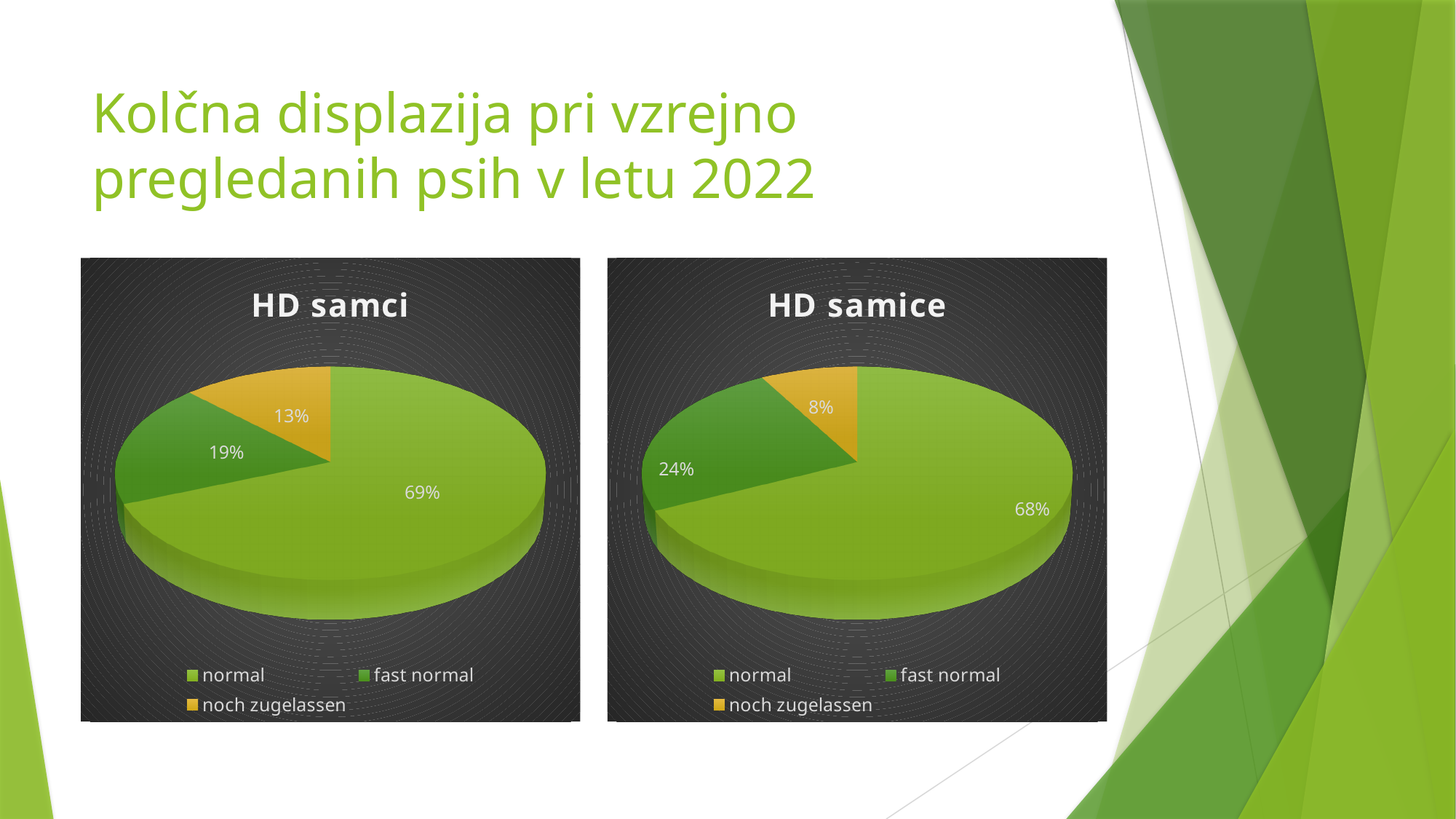
What type of chart is the 'HD samci' chart? pie chart In the 'HD samci' chart, what share of the pie is 'normal'? 69% Which chart has the larger 'fast normal' share, 'HD samci' or 'HD samice'? HD samice In the 'HD samice' chart, which category has the smallest slice? noch zugelassen In the 'HD samice' chart, what share of the pie is 'normal'? 68% In the 'HD samice' chart, what share of the pie is 'noch zugelassen'? 8% How many categories does the legend of the 'HD samice' chart list? 3 In the 'HD samice' chart, what is the difference between the 'fast normal' and 'noch zugelassen' shares? 16% In the 'HD samci' chart, which category has the largest slice? normal